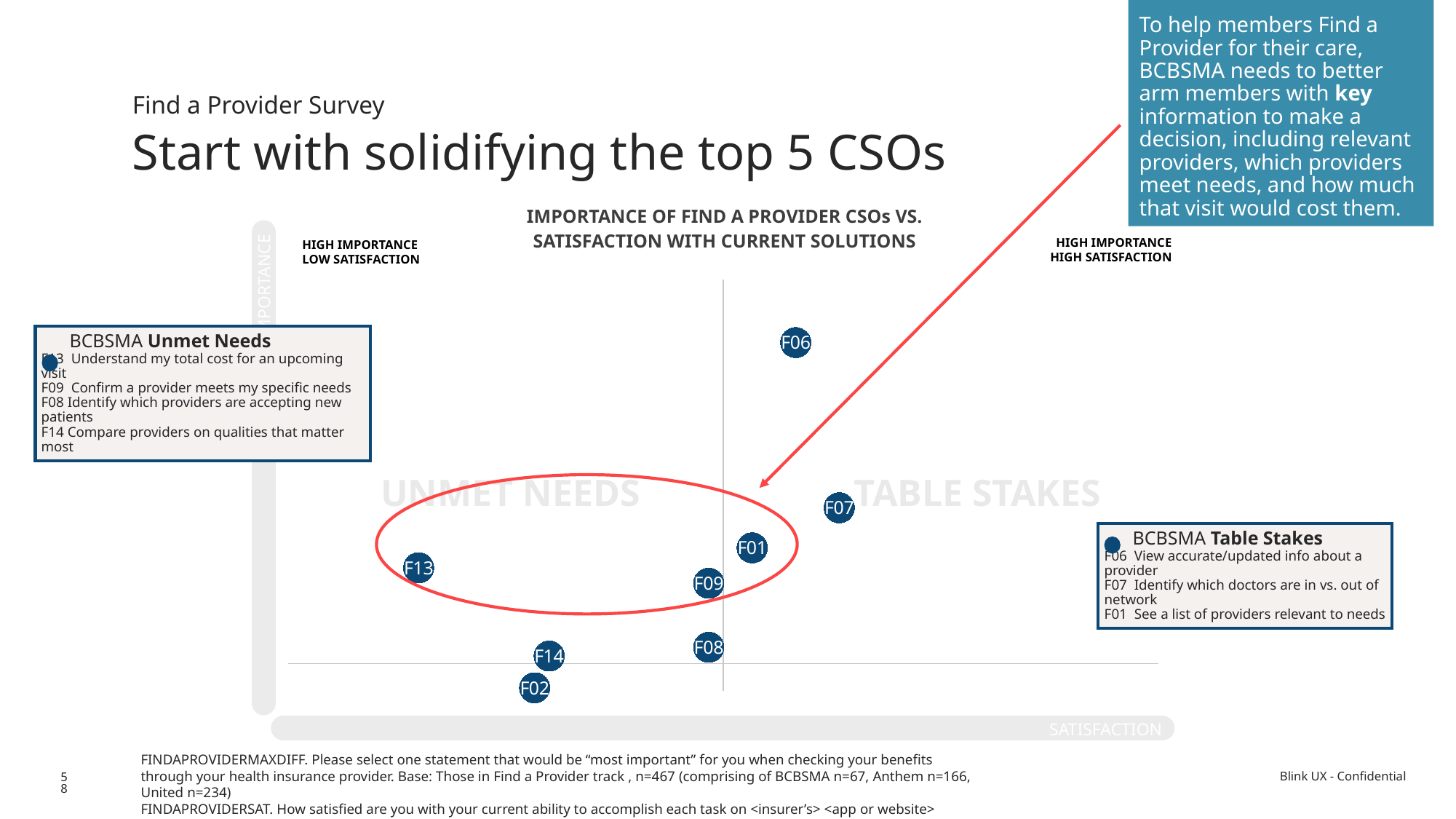
Which point is plotted higher on the importance axis, F13 or F14? F13 What label is shown on the horizontal axis of the chart? SATISFACTION Which point is plotted further right on the satisfaction axis, F01 or F09? F01 What is the title of the chart? IMPORTANCE OF FIND A PROVIDER CSOs VS. SATISFACTION WITH CURRENT SOLUTIONS Which point has the lowest importance (is plotted lowest on the chart)? F02 How many data points are plotted on the chart? 8 Which point has the highest satisfaction (is plotted furthest to the right)? F07 Which point is plotted further right on the satisfaction axis, F07 or F13? F07 What kind of chart is shown on the slide? Scatter plot Which point has the highest importance (is plotted highest on the chart)? F06 Which point has the lowest satisfaction (is plotted furthest to the left)? F13